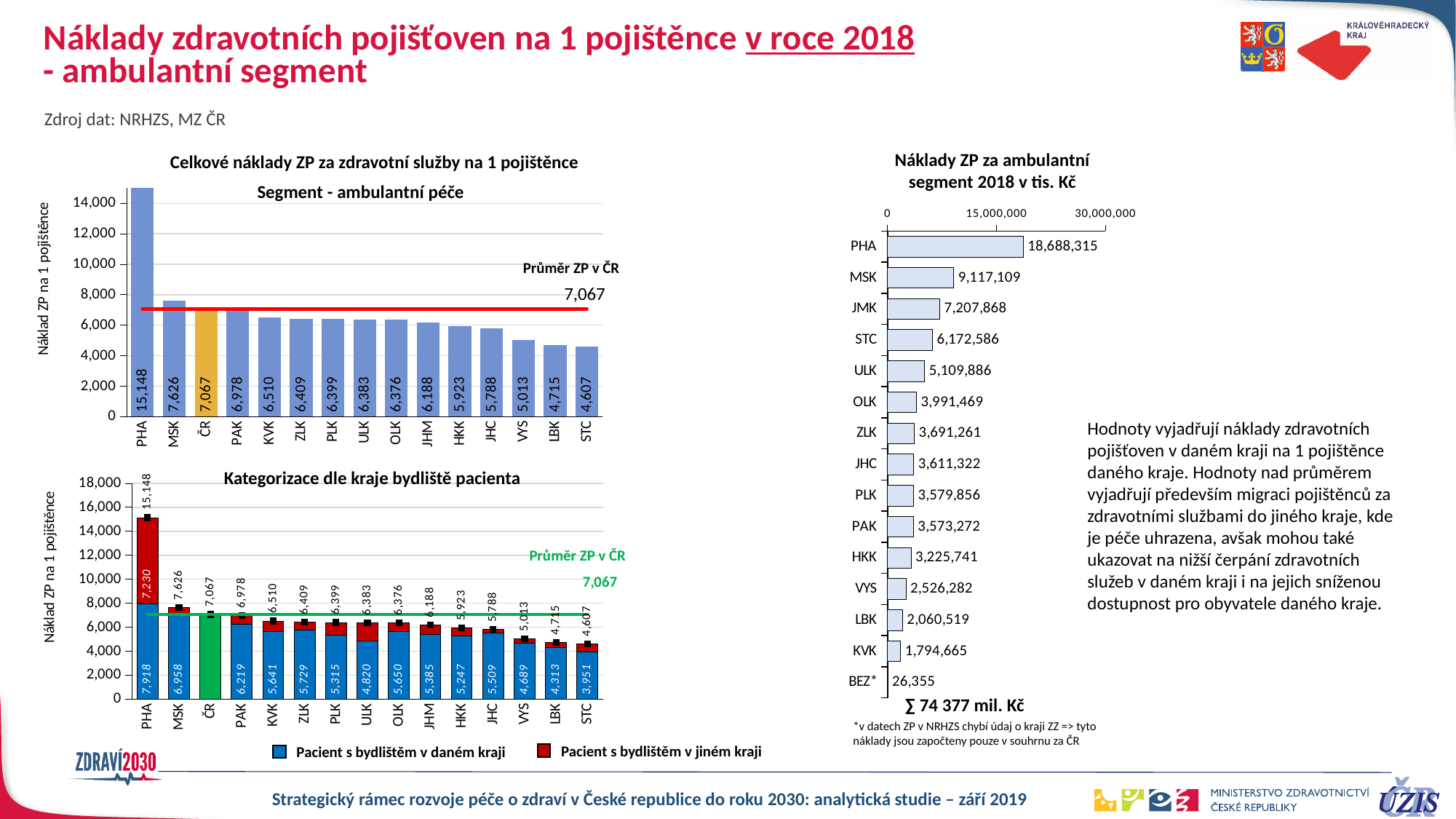
In the top-left chart 'Celkové náklady ZP za zdravotní služby na 1 pojištěnce', what is the difference between the values for MSK and STC? 3,019 In the top-left chart 'Celkové náklady ZP za zdravotní služby na 1 pojištěnce', how many categories are shown on the x axis? 15 In the bottom-left chart 'Kategorizace dle kraje bydliště pacienta', how many series does the legend list? 2 In the top-left chart 'Celkové náklady ZP za zdravotní služby na 1 pojištěnce', what is the value for PHA? 15,148 In the top-left chart 'Celkové náklady ZP za zdravotní služby na 1 pojištěnce', what is the value shown for 'Průměr ZP v ČR'? 7,067 In the bottom-left chart 'Kategorizace dle kraje bydliště pacienta', what is the total of the stacked bar for PHA? 15,148 In the bottom-left chart 'Kategorizace dle kraje bydliště pacienta', what is the value for 'Pacient s bydlištěm v jiném kraji' for PHA? 7,230 What kind of chart is the right chart 'Náklady ZP za ambulantní segment 2018 v tis. Kč'? bar chart In the right chart 'Náklady ZP za ambulantní segment 2018 v tis. Kč', what is the value for JMK? 7,207,868 In the bottom-left chart 'Kategorizace dle kraje bydliště pacienta', what is the value for 'Pacient s bydlištěm v daném kraji' for PHA? 7,918 In the top-left chart 'Celkové náklady ZP za zdravotní služby na 1 pojištěnce', which region has the lowest value? STC In the right chart 'Náklady ZP za ambulantní segment 2018 v tis. Kč', which region has the highest value? PHA